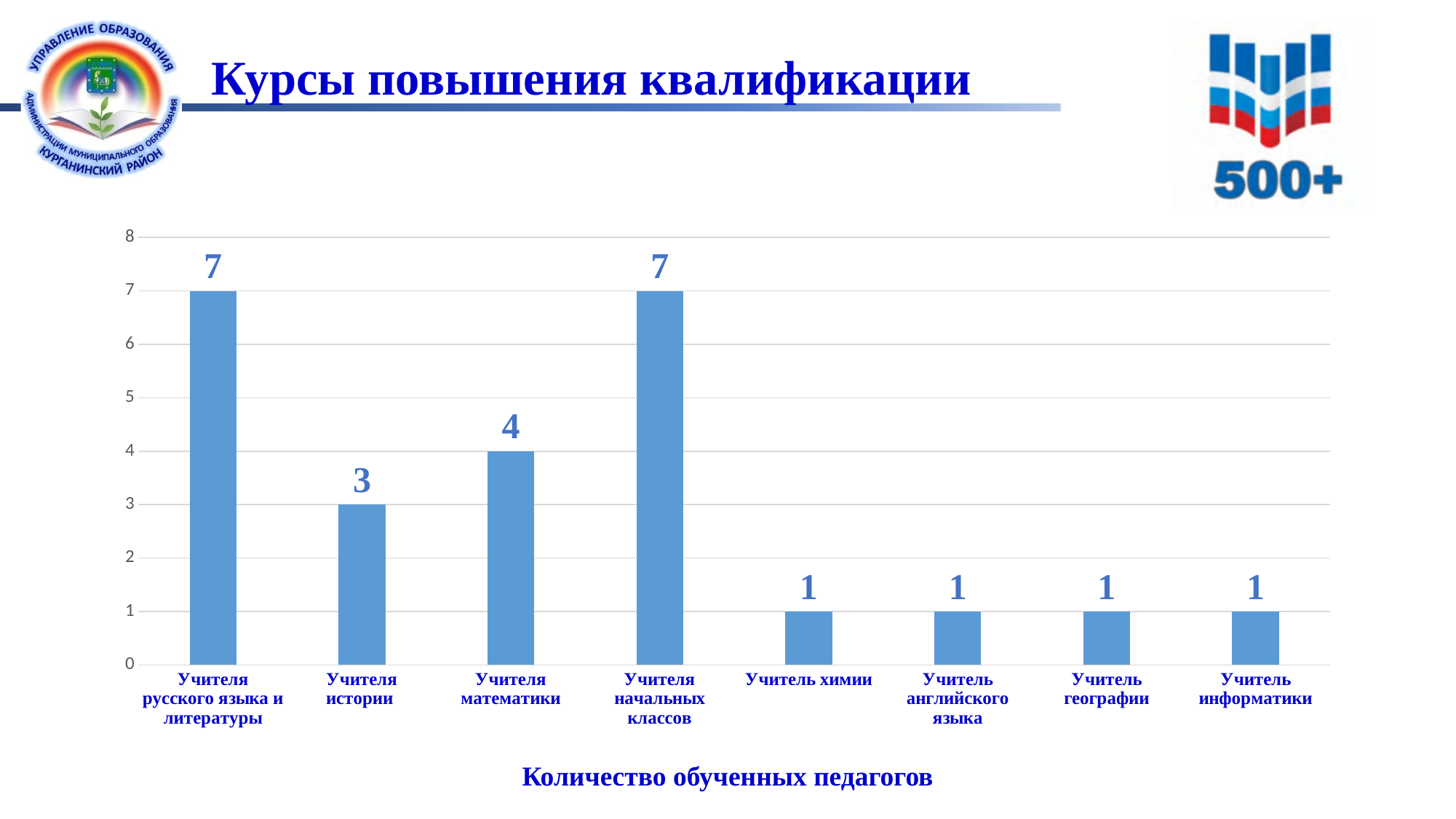
How many categories are shown on the x axis? 8 What is the value for Учителя математики? 4 What is the difference between the values for Учителя математики and Учитель географии? 3 Is the value for Учителя начальных классов greater or less than 5? greater What is the value for Учителя истории? 3 What is the value for Учитель химии? 1 What is the value for Учителя начальных классов? 7 Which category has the lowest value among Учителя русского языка и литературы, Учителя истории and Учителя математики? Учителя истории What is the caption shown below the chart? Количество обученных педагогов What kind of chart is shown on the slide? bar chart Which is larger, the value for Учителя истории or the value for Учитель информатики? Учителя истории What is the difference between the values for Учителя русского языка и литературы and Учителя математики? 3